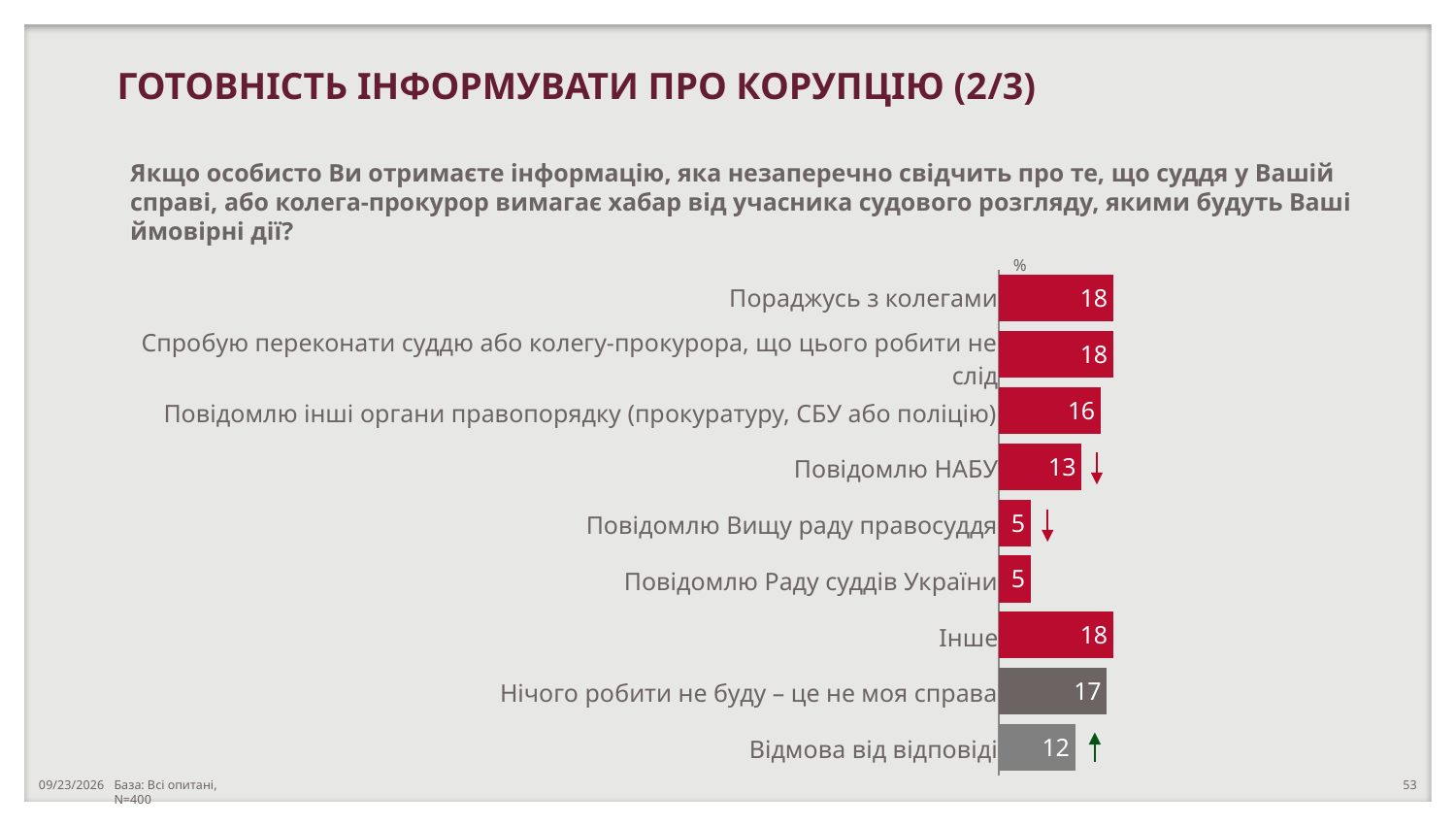
What kind of chart is shown on the slide? Bar chart What is the difference between the value for 'Повідомлю НАБУ' and the value for 'Повідомлю Раду суддів України'? 8 What is the value for 'Нічого робити не буду – це не моя справа'? 17 Which is larger: the value for 'Повідомлю НАБУ' or the value for 'Нічого робити не буду – це не моя справа'? Нічого робити не буду – це не моя справа What is the value for 'Повідомлю НАБУ'? 13 What is the value for 'Повідомлю інші органи правопорядку (прокуратуру, СБУ або поліцію)'? 16 What is the value for 'Відмова від відповіді'? 12 What is the value for 'Повідомлю Вищу раду правосуддя'? 5 How many categories are shown in the chart? 9 What percentage of respondents said they would consult with colleagues (Пораджусь з колегами)? 18 Which two categories are shown with grey bars instead of red ones? Нічого робити не буду – це не моя справа; Відмова від відповіді What is the difference between the value for 'Інше' and the value for 'Відмова від відповіді'? 6